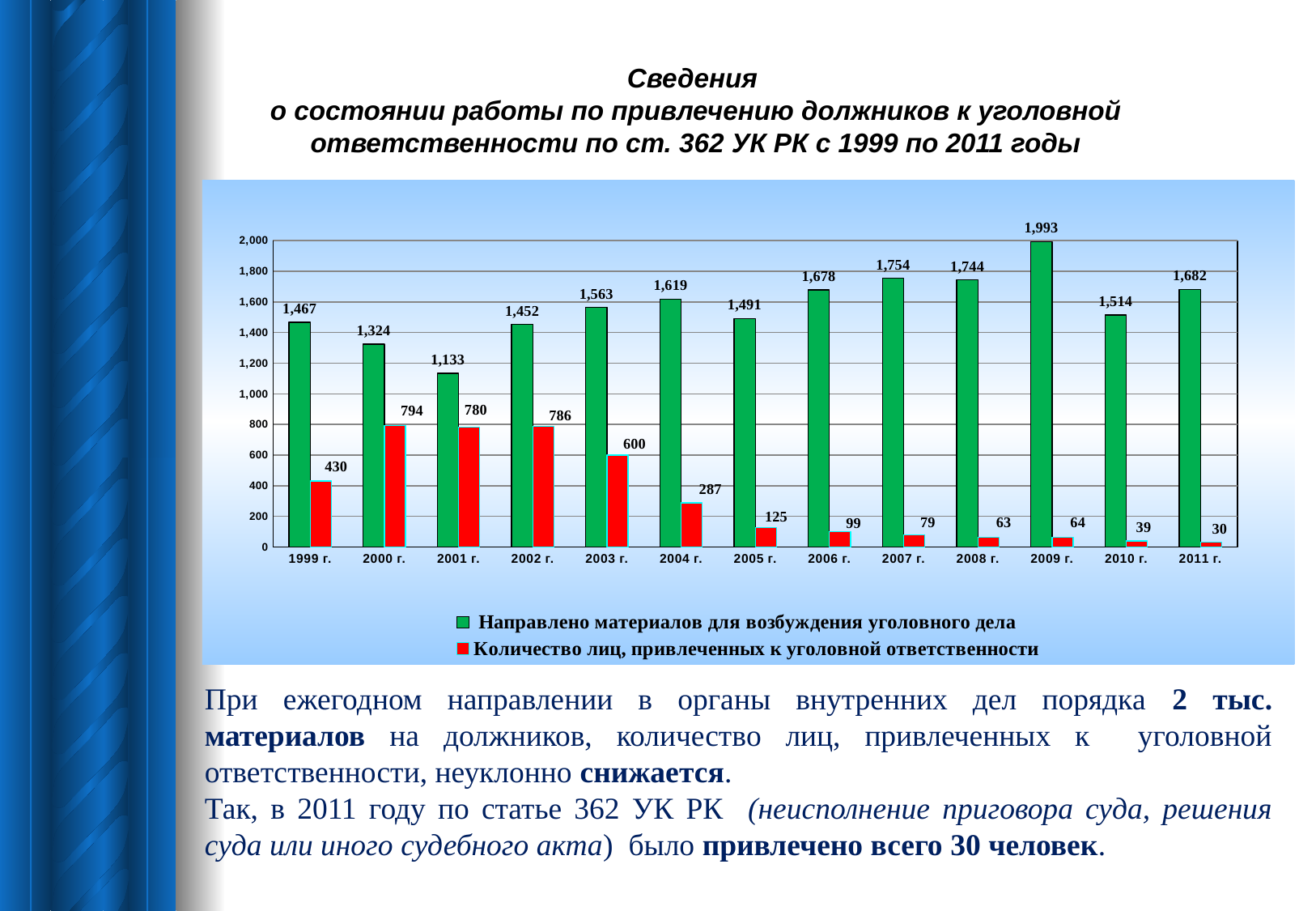
In which year is "Направлено материалов для возбуждения уголовного дела" the lowest? 2001 г. What is the difference between "Направлено материалов для возбуждения уголовного дела" and "Количество лиц, привлеченных к уголовной ответственности" in 2003 г.? 963 How many years are shown on the x axis of the chart? 13 In which year is "Количество лиц, привлеченных к уголовной ответственности" the lowest? 2011 г. Is the value of "Направлено материалов для возбуждения уголовного дела" for 2007 г. greater or less than 1,600? greater What is the value of "Количество лиц, привлеченных к уголовной ответственности" for 2011 г.? 30 How many series does the chart legend list? 2 In which year is "Направлено материалов для возбуждения уголовного дела" the highest? 2009 г. What kind of chart is shown on the slide? Bar chart What is the value of "Количество лиц, привлеченных к уголовной ответственности" for 2000 г.? 794 What is the value of "Направлено материалов для возбуждения уголовного дела" for 2009 г.? 1,993 Which is larger: "Количество лиц, привлеченных к уголовной ответственности" in 2004 г. or in 2005 г.? 2004 г.